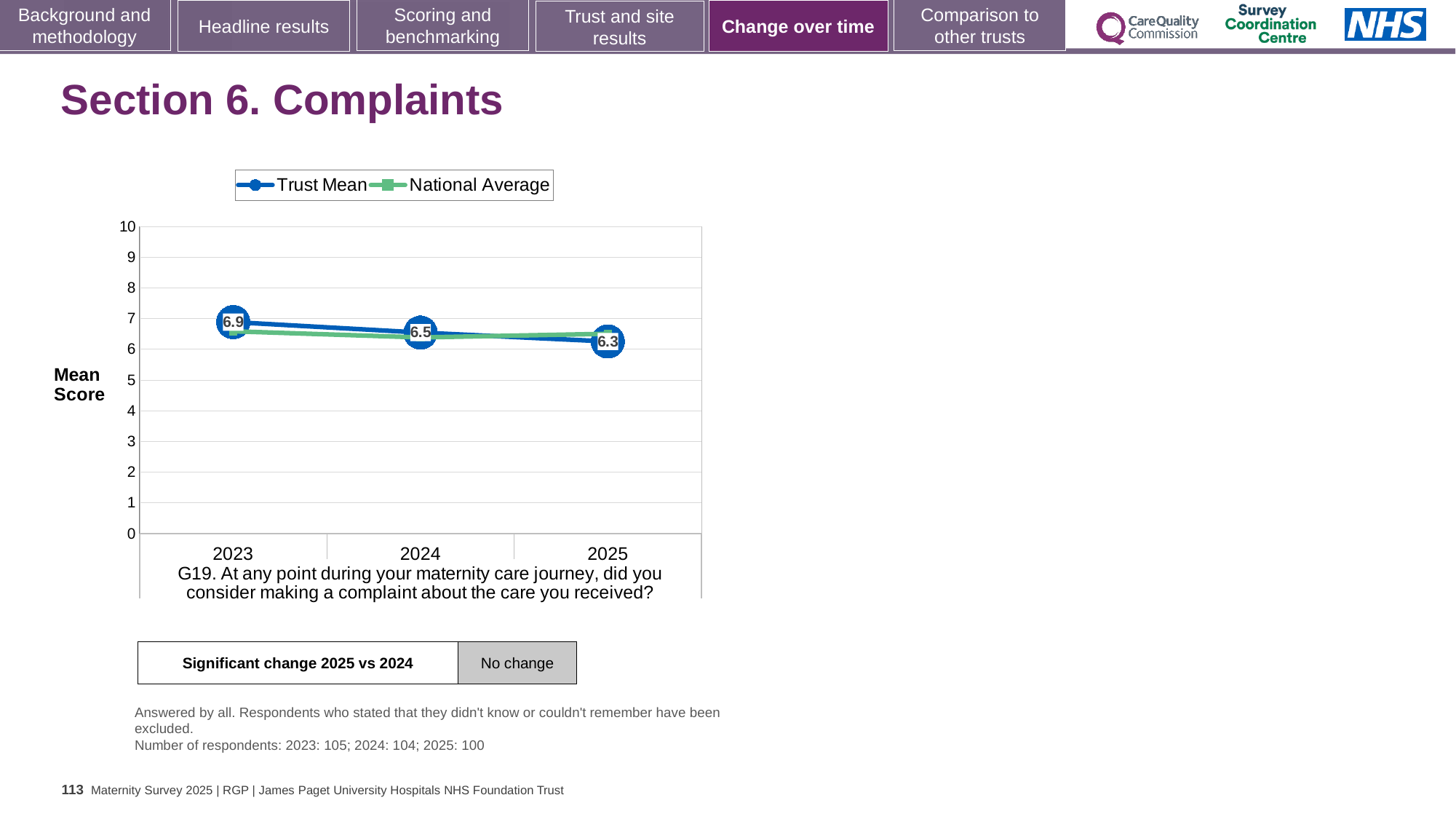
How many series does the legend list? 2 Does the Trust Mean rise or fall from 2023 to 2025? fall What is the difference between the Trust Mean in 2023 and in 2025? 0.6 What kind of chart is shown? line chart Is the National Average for 2023 greater or less than 6? greater What is the Trust Mean score for 2025? 6.3 What is the Trust Mean score for 2024? 6.5 Which is larger, the Trust Mean in 2023 or the Trust Mean in 2024? 2023 What is the Trust Mean score for 2023? 6.9 How many years are shown on the x axis? 3 In which year is the Trust Mean lowest? 2025 In which year is the Trust Mean highest? 2023